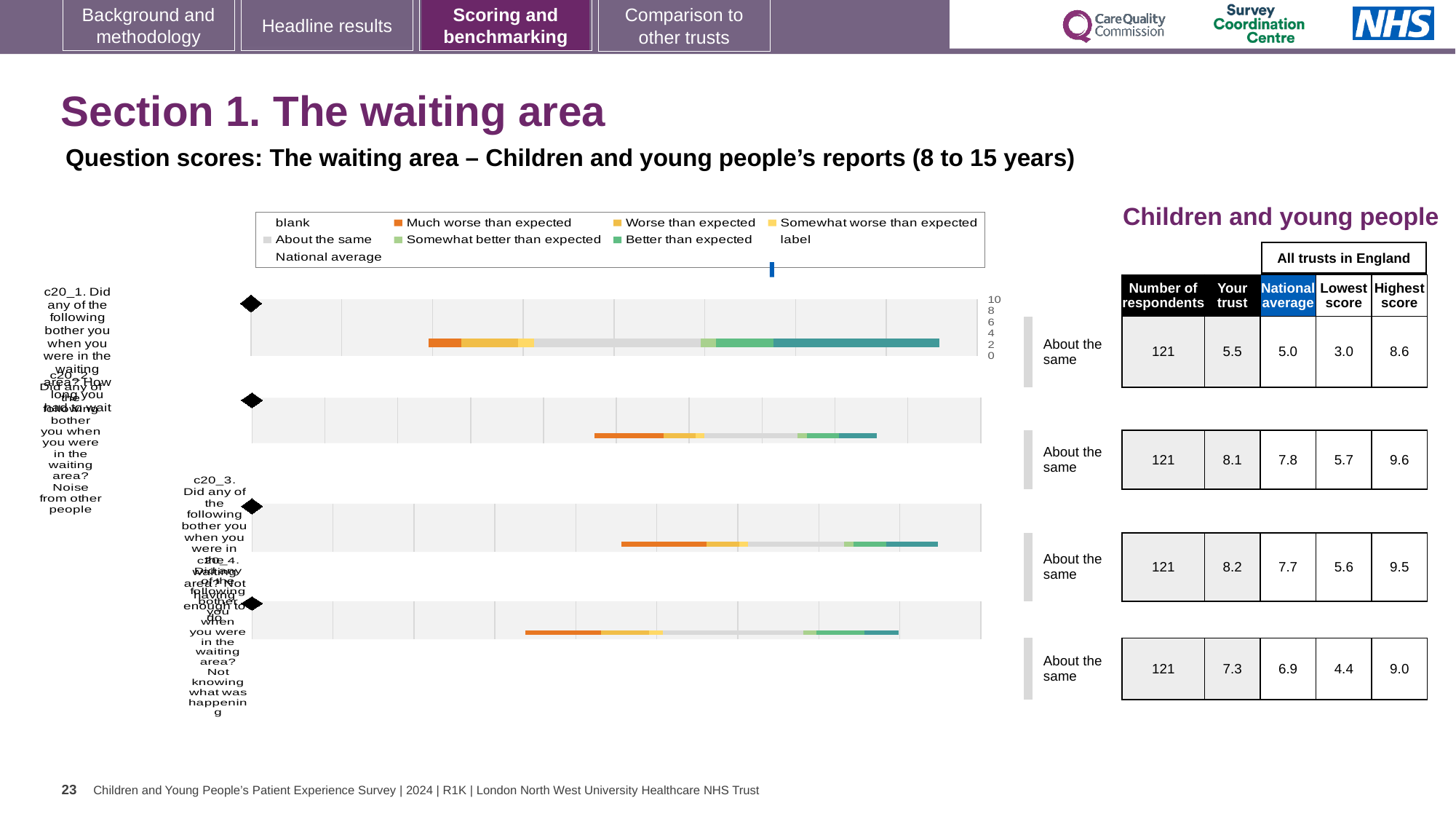
How many question bars (charts) are shown for the waiting area section? 4 What kind of chart is used to show the question scores on this slide? bar chart In the table beside the charts, what is the 'Your trust' score for c20_2 (how long you had to wait)? 8.1 In the table beside the charts, what is the difference between the 'Your trust' score and the national average for c20_1? 0.5 How many entries does the legend above the charts list? 9 In the table beside the charts, what is the national average for c20_1 (noise from other people)? 5.0 In the table beside the charts, for c20_4 (not knowing what was happening), is the 'Your trust' score or the national average larger? Your trust What colour represents 'Much worse than expected' in the legend? orange What colour represents 'Better than expected' in the legend? teal How many respondents are listed for each waiting area question? 121 In the table beside the charts, which question has the lowest 'Your trust' score? c20_1 (noise from other people) In the table beside the charts, which question has the highest 'Your trust' score? c20_3 (not having enough to do)